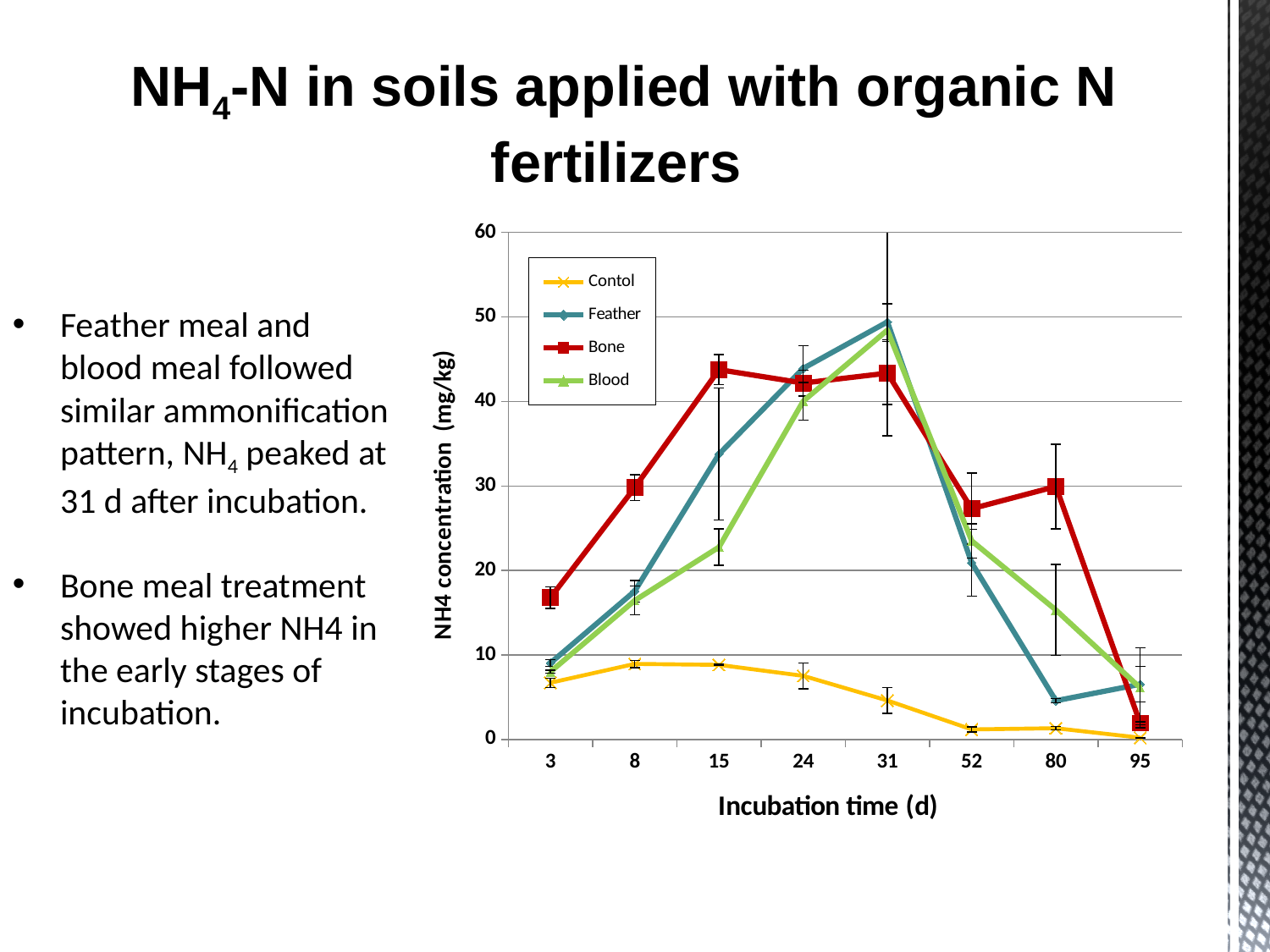
Does the Contol series rise or fall from 31 d to 95 d? fall Is the Bone value at 15 d greater or less than 40? greater How many incubation time points are shown on the x axis? 8 Is the Bone value at 3 d greater or less than 10? greater Which series has the highest NH4 concentration at 3 d? Bone How many series does the chart legend list? 4 Which series has the lowest NH4 concentration at 31 d? Contol Is the Feather value at 31 d greater or less than 40? greater What kind of chart is shown on the slide? line chart At 80 d, which is larger, the Bone value or the Feather value? Bone What is the title of the x axis? Incubation time (d)